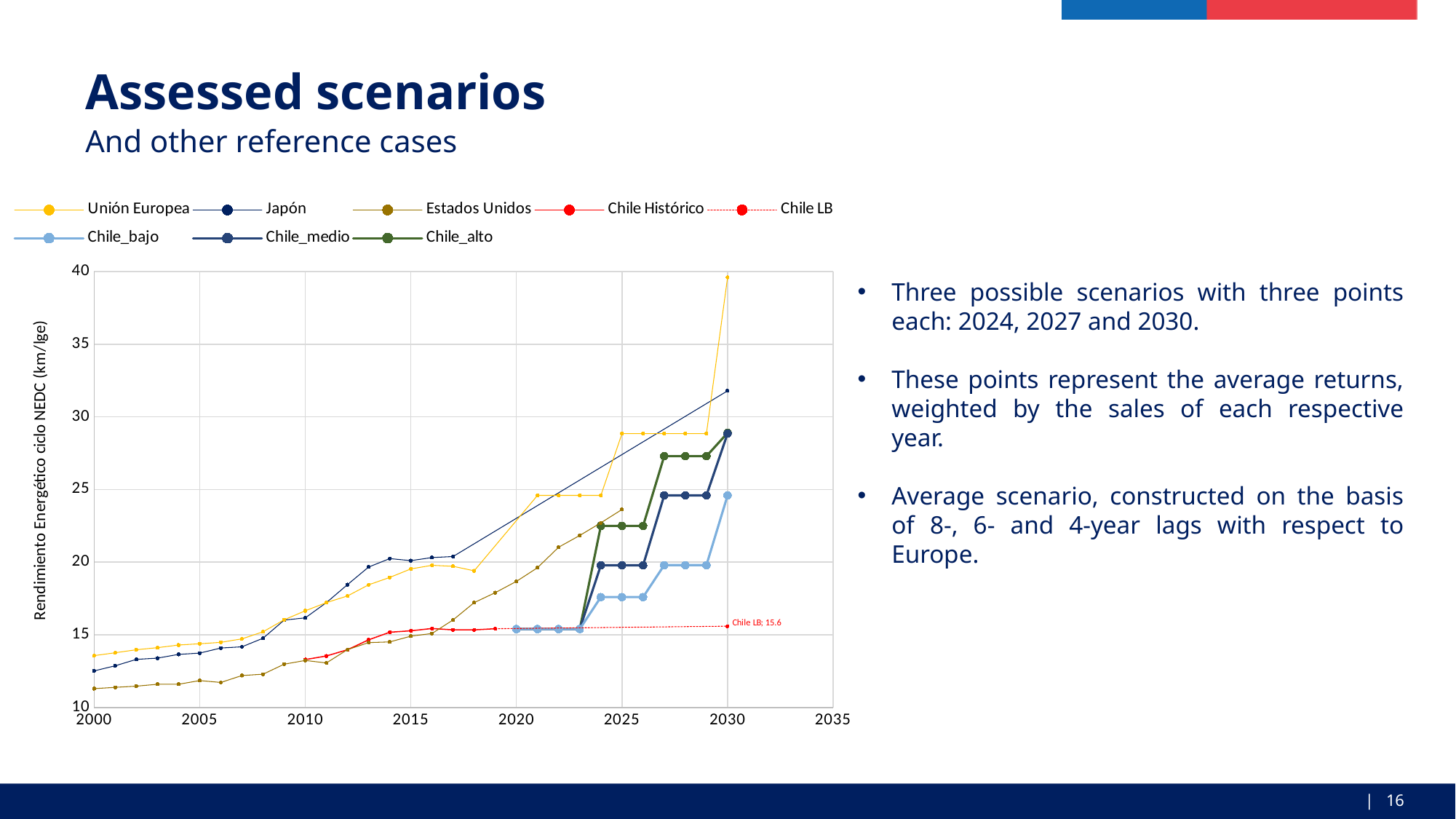
Is the value for Estados Unidos at 2000 greater or less than 15? less Does the Japón series rise or fall from 2000 to 2030? rise Is the value for Japón at 2030 greater or less than 30? greater Which series has the lowest value at 2000? Estados Unidos What is the label of the vertical axis of the chart? Rendimiento Energético ciclo NEDC (km/lge) What value is labelled for Chile LB at 2030? 15.6 What kind of chart is shown on the slide? line chart Is the value for Unión Europea at 2030 greater or less than 35? greater Which series has the highest value at 2030? Unión Europea At 2030, which is larger: Chile_alto or Chile_bajo? Chile_alto How many series does the chart legend list? 8